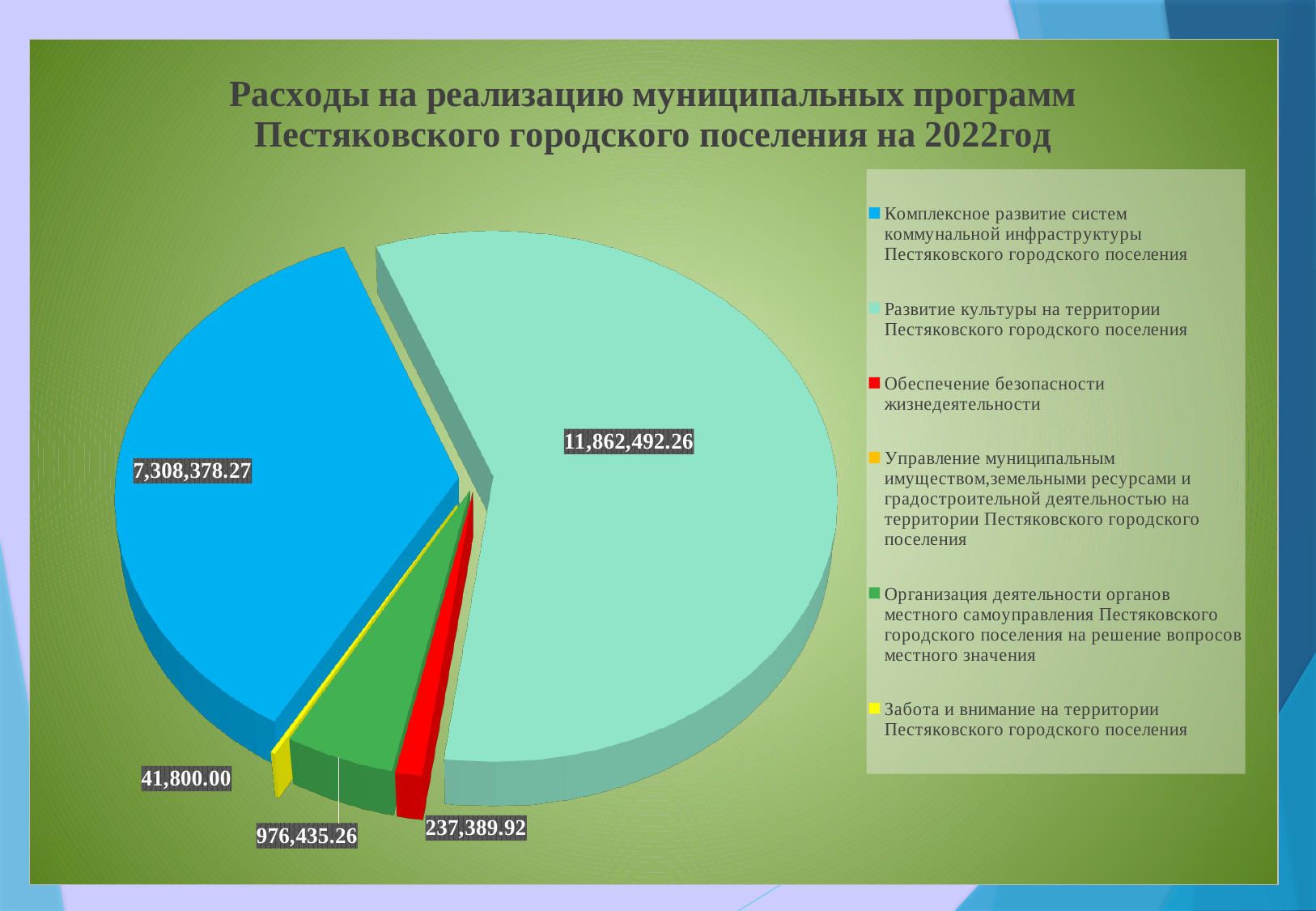
Which category has the largest slice of the pie? Развитие культуры на территории Пестяковского городского поселения What is the difference between the value for "Развитие культуры" and the value for "Комплексное развитие систем коммунальной инфраструктуры"? 4,554,113.99 What type of chart is shown on the slide? Pie chart How many entries does the legend list? 6 What is the value for "Развитие культуры на территории Пестяковского городского поселения"? 11,862,492.26 What is the value for "Обеспечение безопасности жизнедеятельности"? 237,389.92 What is the difference between the value for "Организация деятельности органов местного самоуправления" and the value for "Обеспечение безопасности жизнедеятельности"? 739,045.34 What is the value for "Забота и внимание на территории Пестяковского городского поселения"? 41,800.00 What is the value for "Комплексное развитие систем коммунальной инфраструктуры Пестяковского городского поселения"? 7,308,378.27 What is the title of the chart? Расходы на реализацию муниципальных программ Пестяковского городского поселения на 2022год Which is larger: the value for "Организация деятельности органов местного самоуправления" or the value for "Обеспечение безопасности жизнедеятельности"? Организация деятельности органов местного самоуправления What is the value for "Организация деятельности органов местного самоуправления Пестяковского городского поселения на решение вопросов местного значения"? 976,435.26